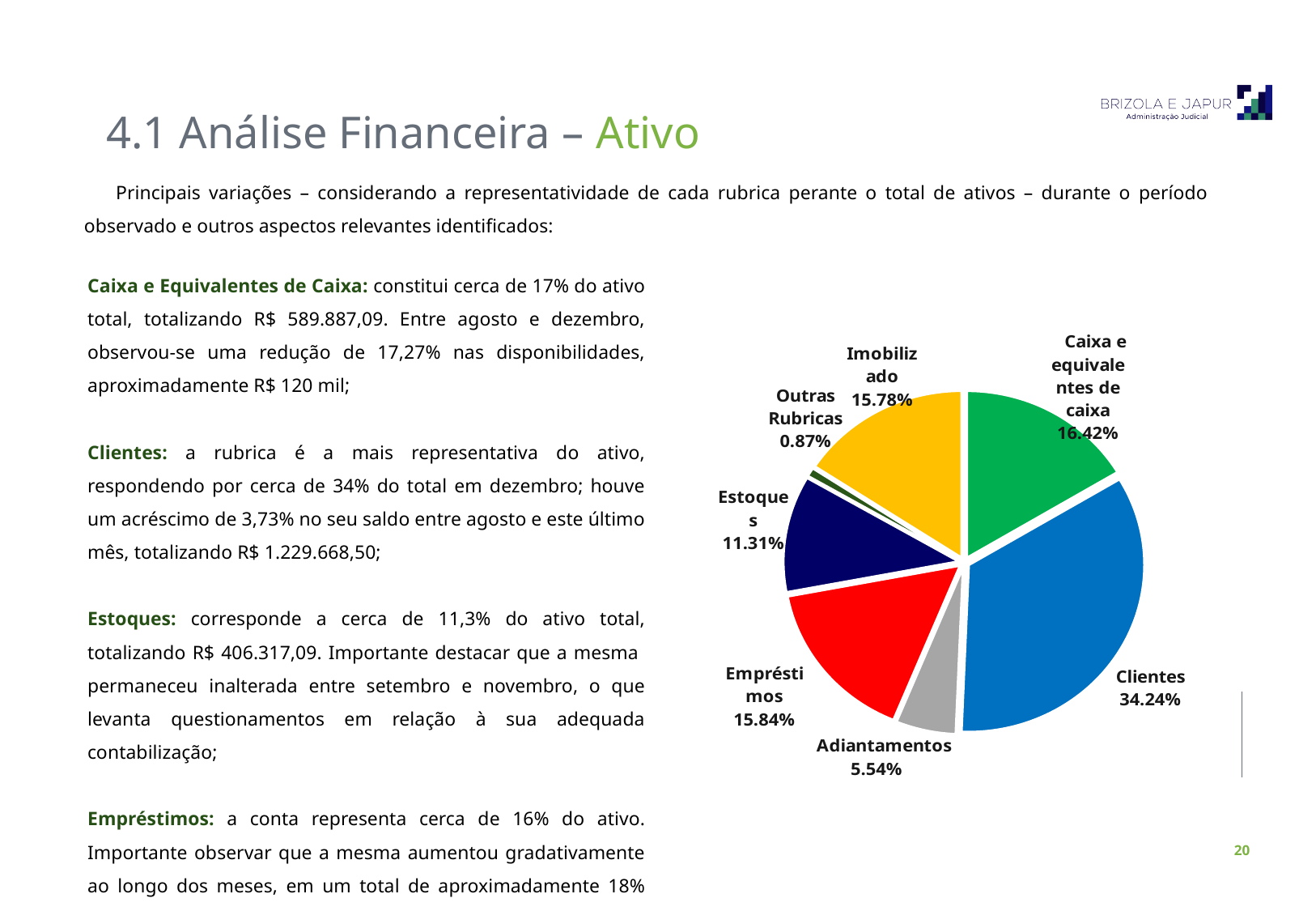
Which category has the largest slice in the pie chart? Clientes What is the difference in percentage points between Clientes and Caixa e equivalentes de caixa? 17.82 What is the value labelled for Adiantamentos in the pie chart? 5.54% What colour is the Clientes slice in the pie chart? Blue Which is larger in the pie chart, Empréstimos or Estoques? Empréstimos How many slices does the pie chart have? 7 What is the combined share of Imobilizado and Empréstimos in the pie chart? 31.62% Which category has the smallest slice in the pie chart? Outras Rubricas What percentage is shown for Estoques in the pie chart? 11.31% What type of chart is shown on the slide? Pie chart What percentage does the pie chart show for Caixa e equivalentes de caixa? 16.42% What share of the pie chart does Clientes represent? 34.24%